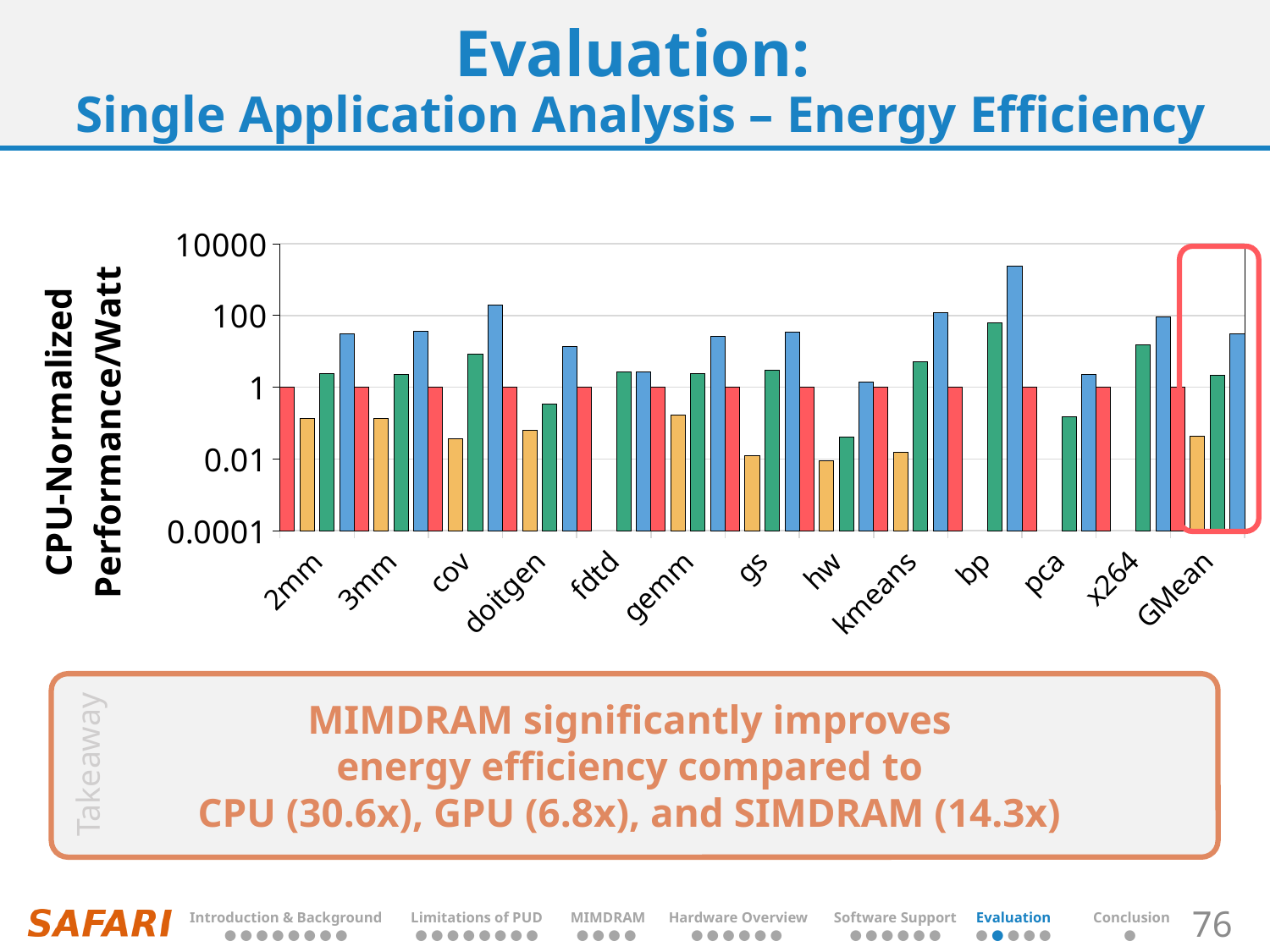
Is the value of the green bar for doitgen greater or less than 1? less Is the value of the orange bar for GMean greater or less than 1? less Is the value of the blue bar for bp greater or less than 100? greater Which is larger, the green bar for pca or the green bar for x264? x264 What is the label of the y axis of the chart? CPU-Normalized Performance/Watt How many categories are shown along the x axis of the chart? 13 Which category has the tallest blue bar in the chart? bp Which category on the x axis is highlighted with a red rounded box? GMean What kind of chart is shown on the slide? bar chart How many bars are plotted for each category in the chart? 4 for most categories, but only 3 for fdtd, bp, pca and x264 (no orange bar) Which is larger, the blue bar for bp or the blue bar for doitgen? bp